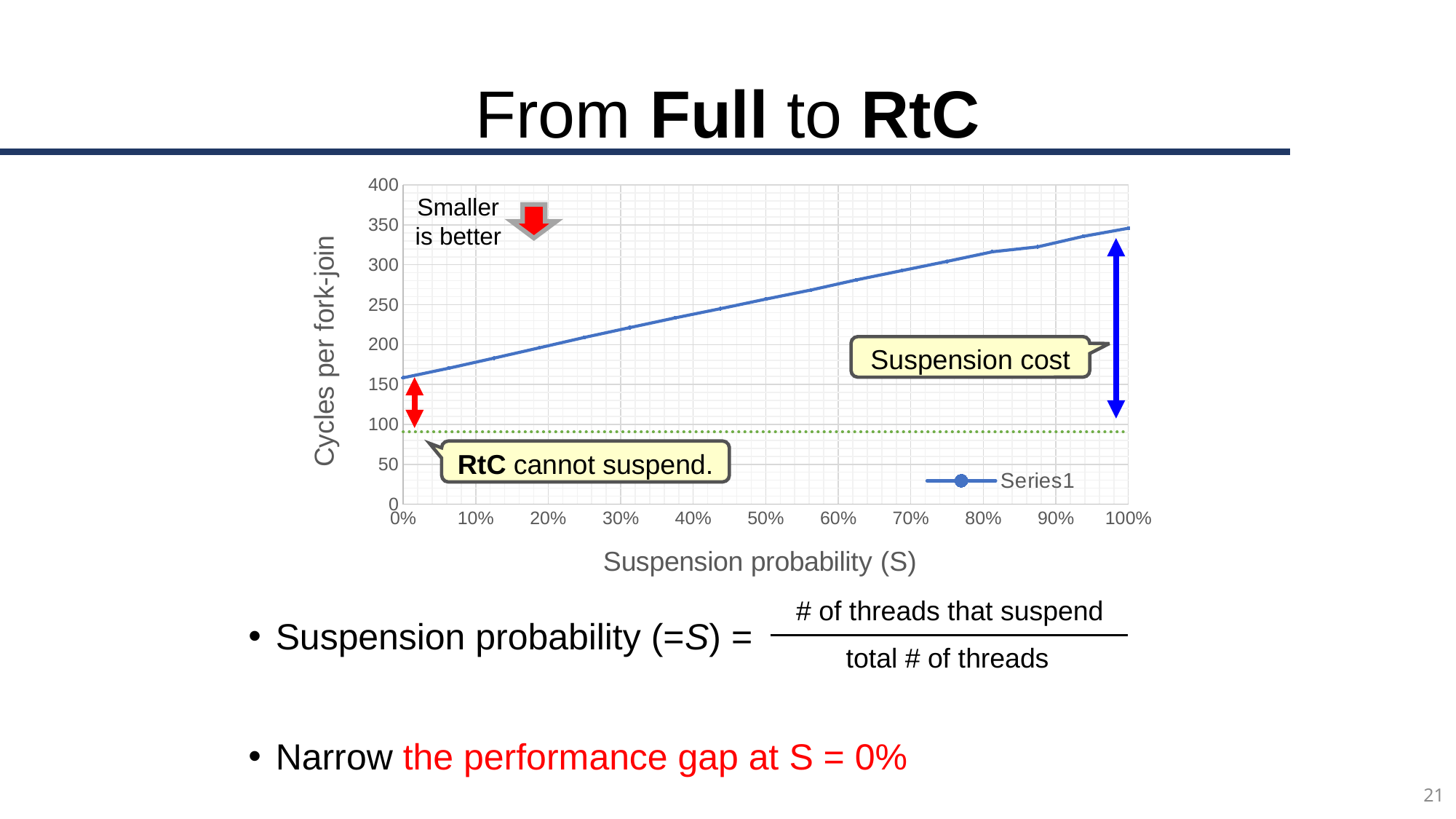
Is the value of Series1 at a suspension probability of 100% greater or less than 300? greater Is the value of Series1 at a suspension probability of 0% greater or less than 100? greater How many series does the chart legend list? 1 Which is larger, the value of Series1 at 20% suspension probability or at 80% suspension probability? 80% Is the value of Series1 at a suspension probability of 50% greater or less than 200? greater What is the name of the series shown in the chart legend? Series1 At which suspension probability does Series1 reach its highest value? 100% What kind of chart is shown on the slide? line chart What is the label of the y axis of the chart? Cycles per fork-join At which suspension probability does Series1 have its lowest value? 0% Do the values of Series1 rise or fall as the suspension probability increases from 0% to 100%? rise